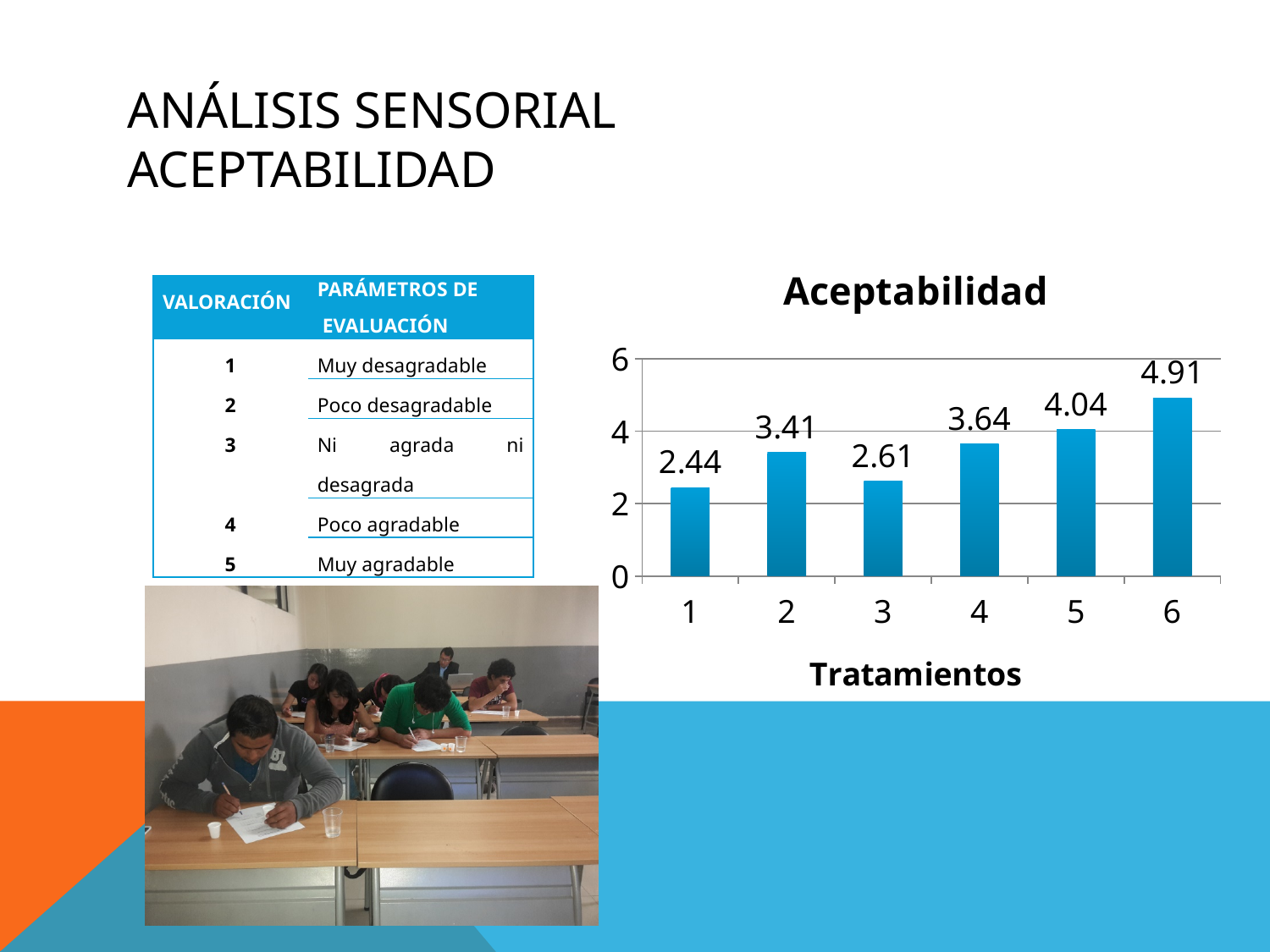
What is the difference between the values for treatment 5 and treatment 4? 0.40 Which has a larger value, treatment 2 or treatment 3? Treatment 2 What is the value for treatment 4 in the Aceptabilidad chart? 3.64 What is the value for treatment 1 in the Aceptabilidad chart? 2.44 Is the value for treatment 5 greater or less than 4? greater What is the value for treatment 6 in the Aceptabilidad chart? 4.91 Which treatment has the lowest acceptability value? 1 What kind of chart is the Aceptabilidad chart? Bar chart What is the x-axis label of the Aceptabilidad chart? Tratamientos How many treatments are shown in the Aceptabilidad chart? 6 What is the difference between the values for treatment 6 and treatment 1? 2.47 Which treatment has the highest acceptability value? 6